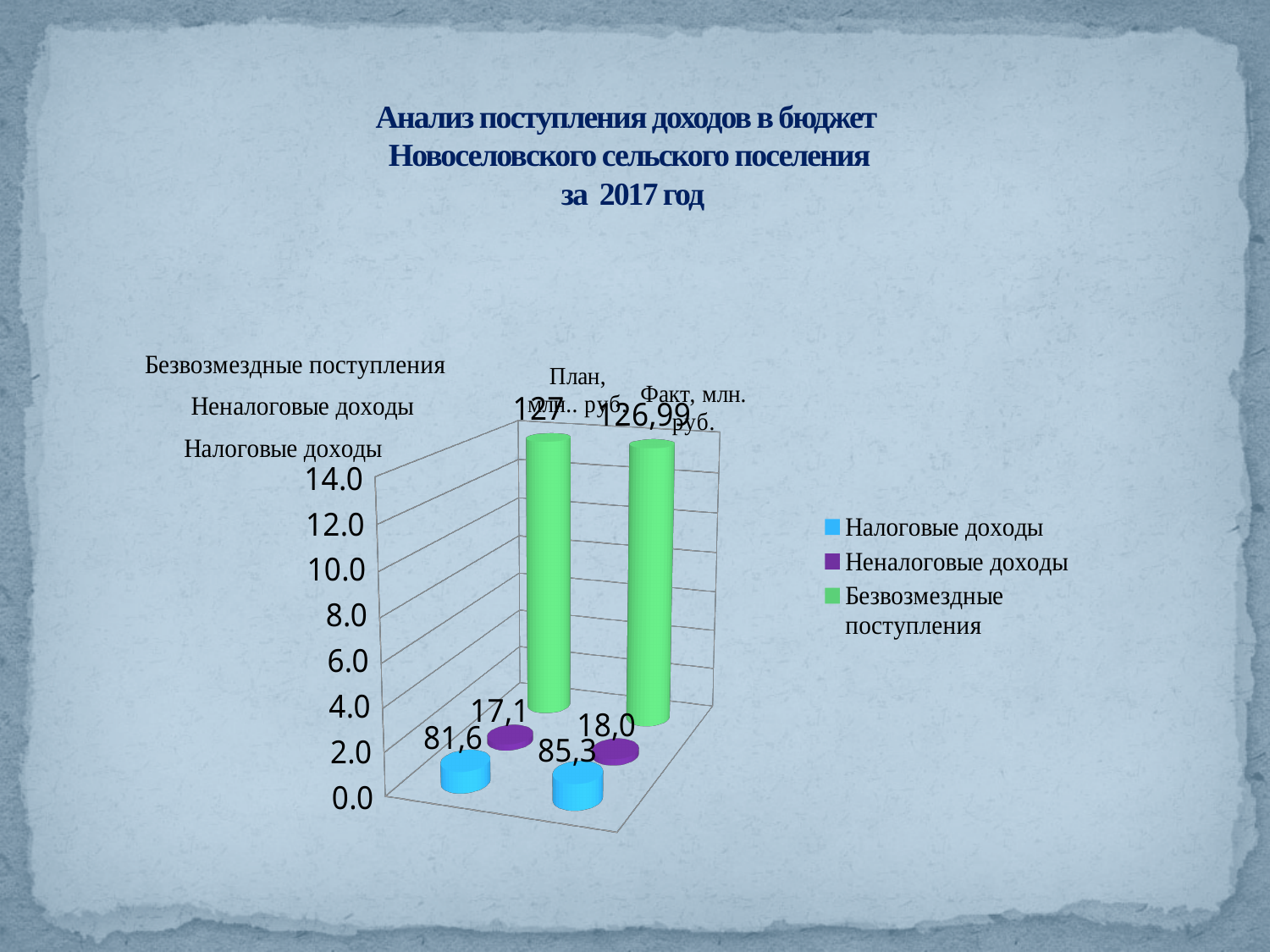
What is the data label for Неналоговые доходы in the Факт category? 18,0 What is the data label for Безвозмездные поступления in the Факт category? 126,99 What is the data label for Налоговые доходы in the Факт category? 85,3 What is the data label for Безвозмездные поступления in the План category? 127 What is the data label for Налоговые доходы in the План category? 81,6 What is the data label for Неналоговые доходы in the План category? 17,1 What colour represents Безвозмездные поступления in the legend? green What kind of chart is shown on the slide? bar chart Which series has the shortest bars in the chart? Неналоговые доходы Which series has the tallest bars in the chart? Безвозмездные поступления How many categories are shown on the x axis? 2 How many series does the legend list? 3